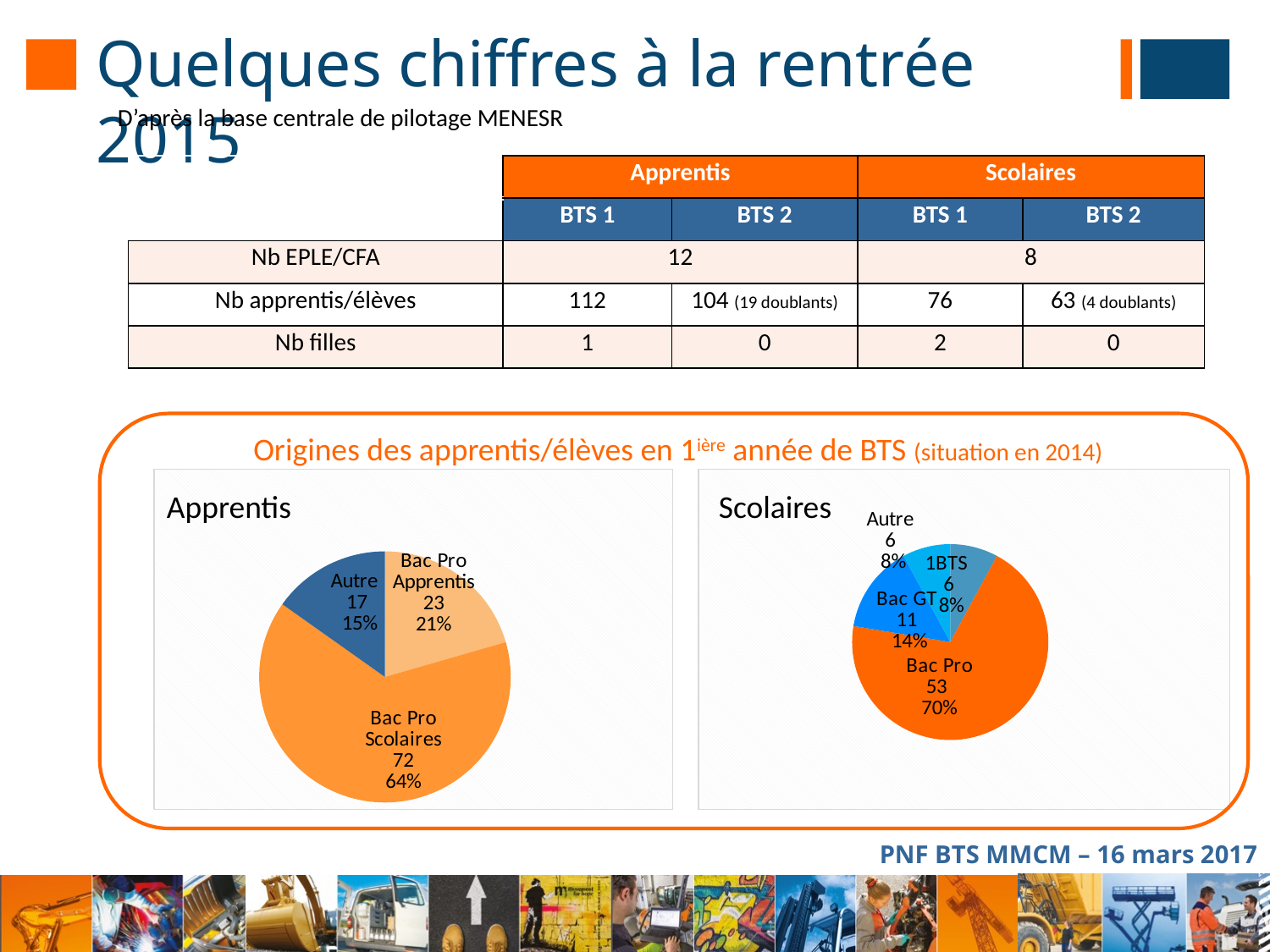
In the Apprentis pie chart, which category is the smallest? Autre How many categories does the Apprentis pie chart show? 3 In the Apprentis pie chart, which category is the largest? Bac Pro Scolaires In the Apprentis pie chart, how many apprentices come from Bac Pro Scolaires? 72 How many categories does the Scolaires pie chart show? 4 In the Scolaires pie chart, which is larger, Bac GT or Autre? Bac GT In the Apprentis pie chart, what is the difference between the Bac Pro Scolaires value and the Bac Pro Apprentis value? 49 In the Scolaires pie chart, which category is the largest? Bac Pro In the Apprentis pie chart, what share of the pie does Bac Pro Apprentis represent? 21% In the Scolaires pie chart, what share of the pie does Bac GT represent? 14% In the Scolaires pie chart, how many students come from Bac Pro? 53 What type of chart is used for the Apprentis and Scolaires charts? Pie chart